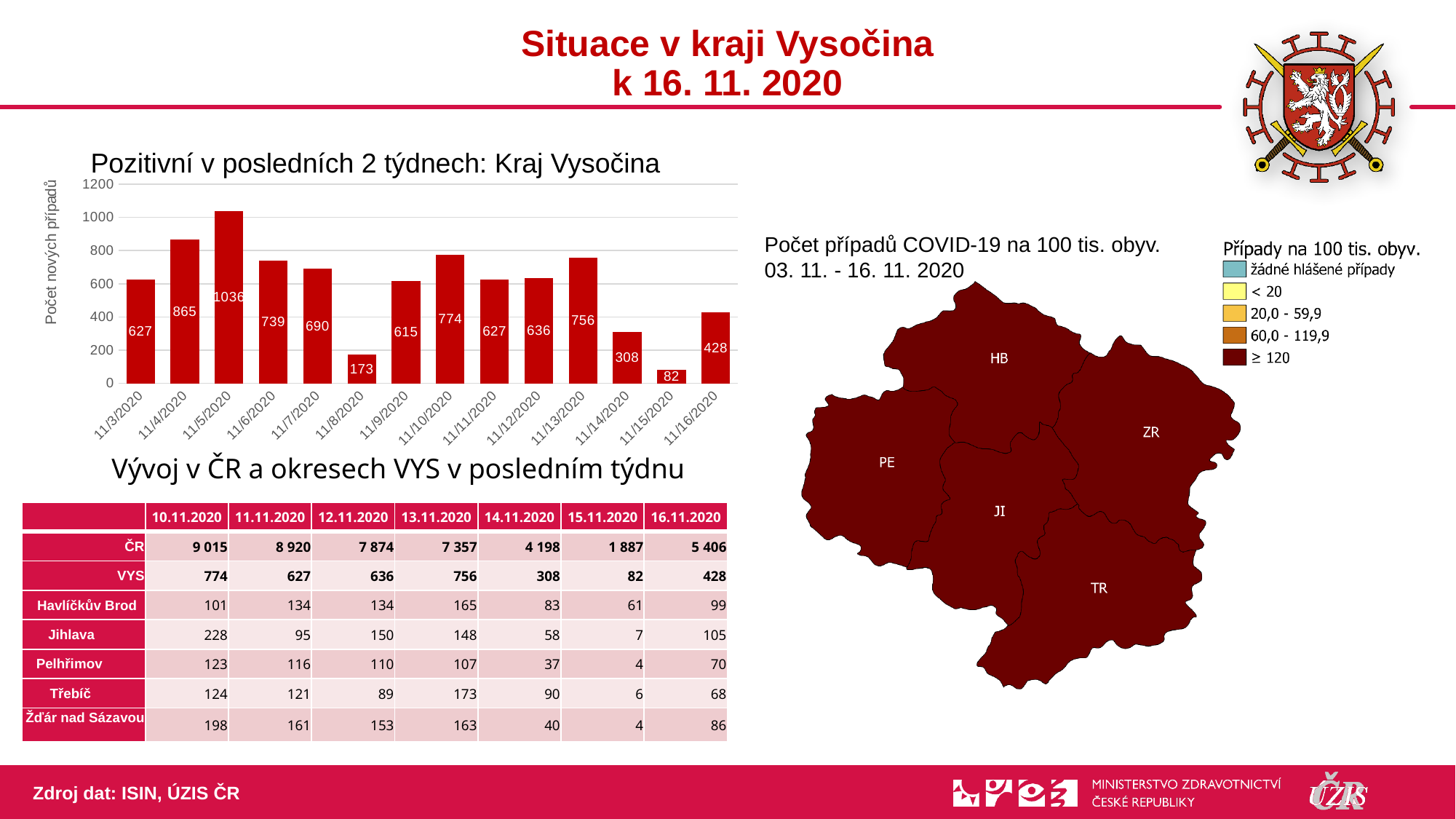
In the chart 'Pozitivní v posledních 2 týdnech: Kraj Vysočina', what is the difference between the values for 11/4/2020 and 11/3/2020? 238 In the chart 'Pozitivní v posledních 2 týdnech: Kraj Vysočina', what is the value for 11/8/2020? 173 What kind of chart is 'Pozitivní v posledních 2 týdnech: Kraj Vysočina'? bar chart In the chart 'Pozitivní v posledních 2 týdnech: Kraj Vysočina', what is the value for 11/16/2020? 428 In the chart 'Pozitivní v posledních 2 týdnech: Kraj Vysočina', which date has the highest value? 11/5/2020 In the chart 'Pozitivní v posledních 2 týdnech: Kraj Vysočina', do the values rise or fall from 11/13/2020 to 11/15/2020? fall In the chart 'Pozitivní v posledních 2 týdnech: Kraj Vysočina', which date has the lowest value? 11/15/2020 In the chart 'Pozitivní v posledních 2 týdnech: Kraj Vysočina', is the value for 11/4/2020 greater or less than 800? greater In the chart 'Pozitivní v posledních 2 týdnech: Kraj Vysočina', what is the difference between the values for 11/5/2020 and 11/15/2020? 954 In the chart 'Pozitivní v posledních 2 týdnech: Kraj Vysočina', what is the value for 11/5/2020? 1036 In the chart 'Pozitivní v posledních 2 týdnech: Kraj Vysočina', which is larger, the value for 11/10/2020 or 11/13/2020? 11/10/2020 How many dates (bars) are shown in the chart 'Pozitivní v posledních 2 týdnech: Kraj Vysočina'? 14